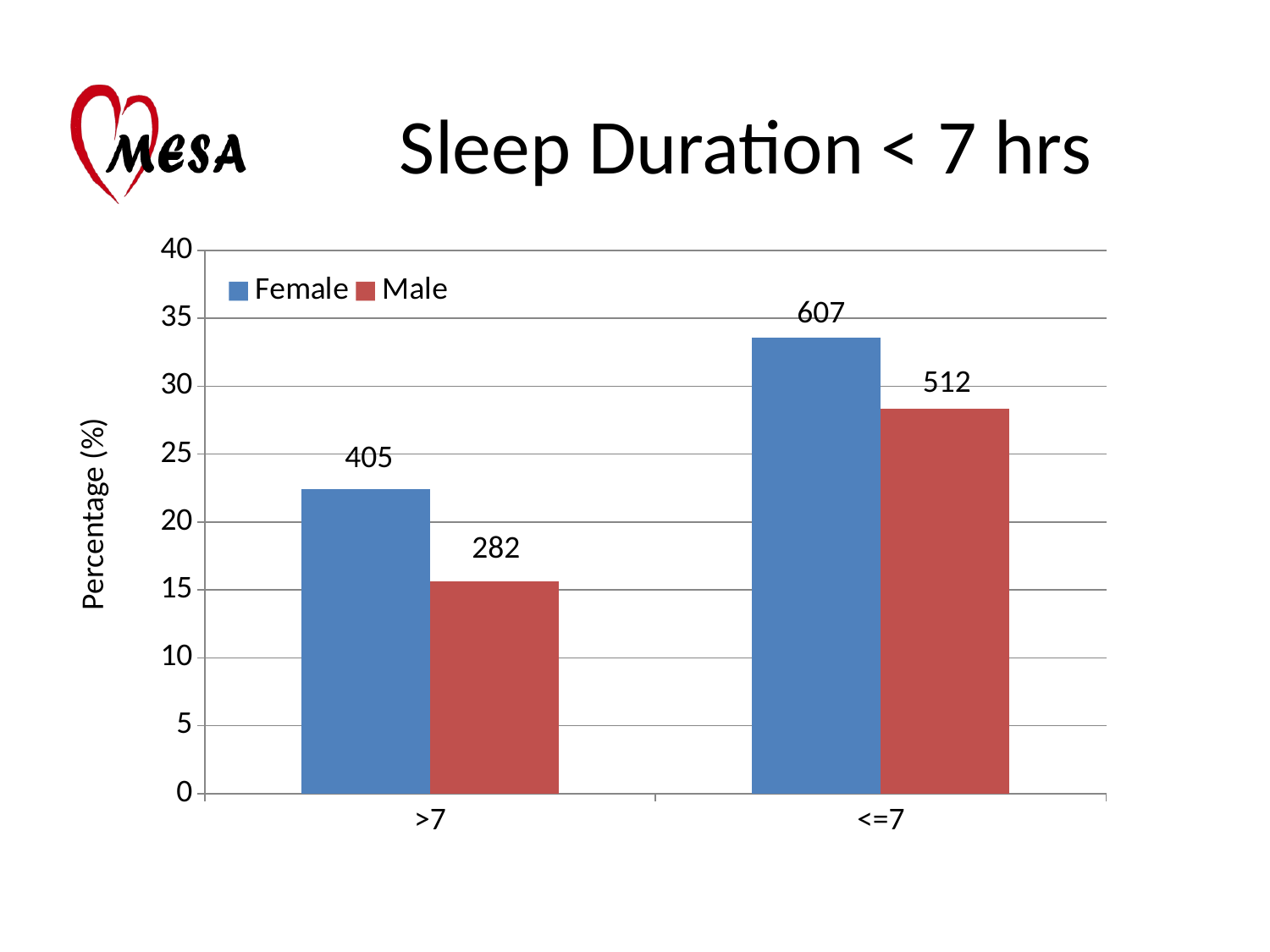
Which bar is the tallest in the chart? Female, <=7 How many categories are shown on the x axis? 2 How many series does the legend list? 2 What is the data label on the Male bar for the >7 category? 282 Is the percentage for Female in the >7 category greater or less than 20? greater What are the two series named in the legend? Female and Male Which bar is the shortest in the chart? Male, >7 What type of chart is shown on the slide? bar chart What is the data label on the Female bar for the >7 category? 405 What is the data label on the Male bar for the <=7 category? 512 Is the percentage for Male in the <=7 category greater or less than 30? less What is the data label on the Female bar for the <=7 category? 607